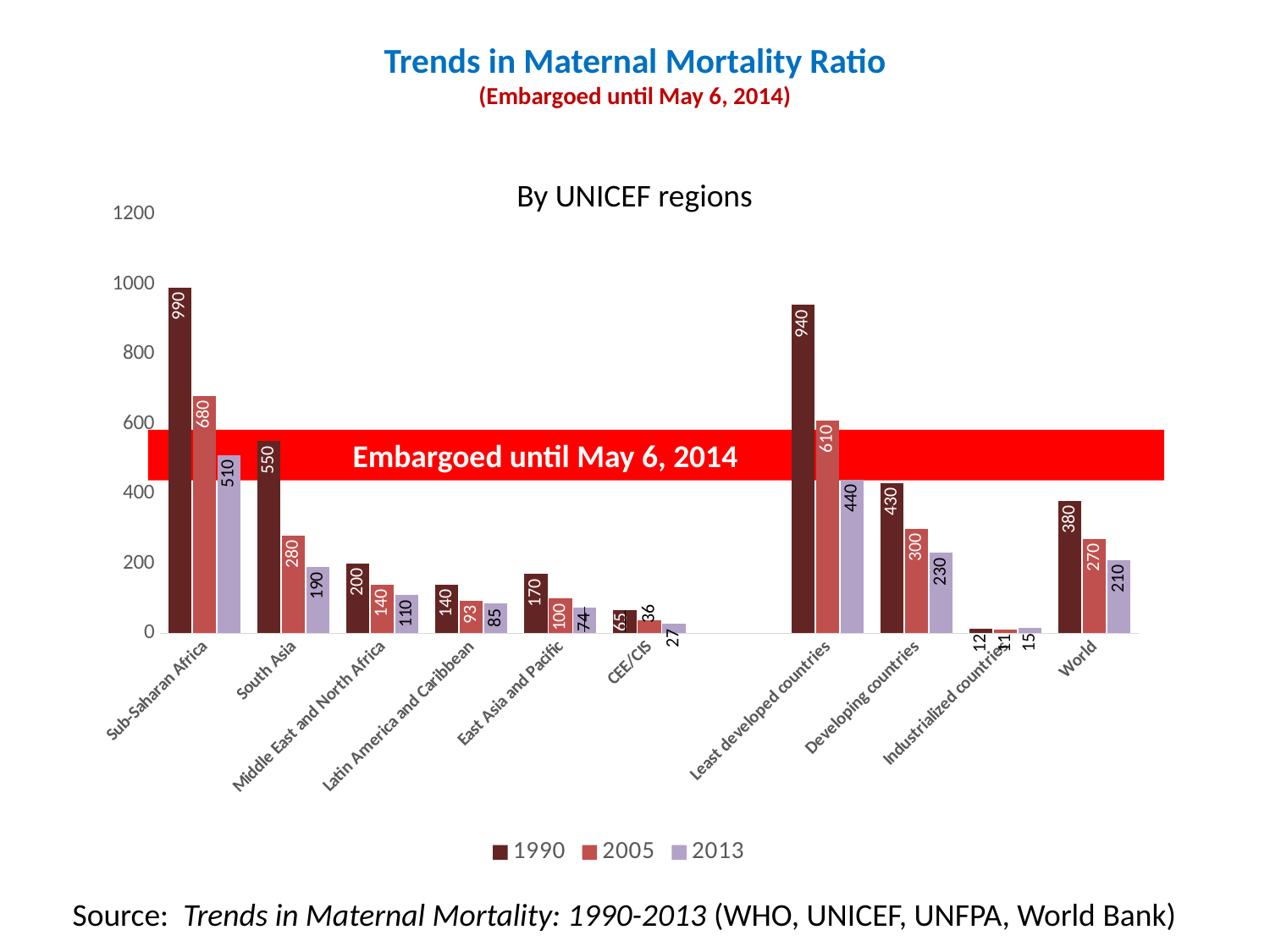
Which category has the lowest 2005 value? Industrialized countries What is the 2005 value for World? 270 What is the 2013 value for Least developed countries? 440 Which category has the highest 1990 value? Sub-Saharan Africa Which is larger, the 2013 value for Developing countries or the 2013 value for World? Developing countries For Sub-Saharan Africa, do the values rise or fall from 1990 to 2013? Fall How many series does the legend list? 3 Is the 2005 value for Least developed countries greater or less than 600? greater What is the difference between the 1990 and 2013 values for South Asia? 360 How many categories are shown on the x axis? 10 What kind of chart is shown on the slide? Bar chart What is the 1990 value for Sub-Saharan Africa? 990